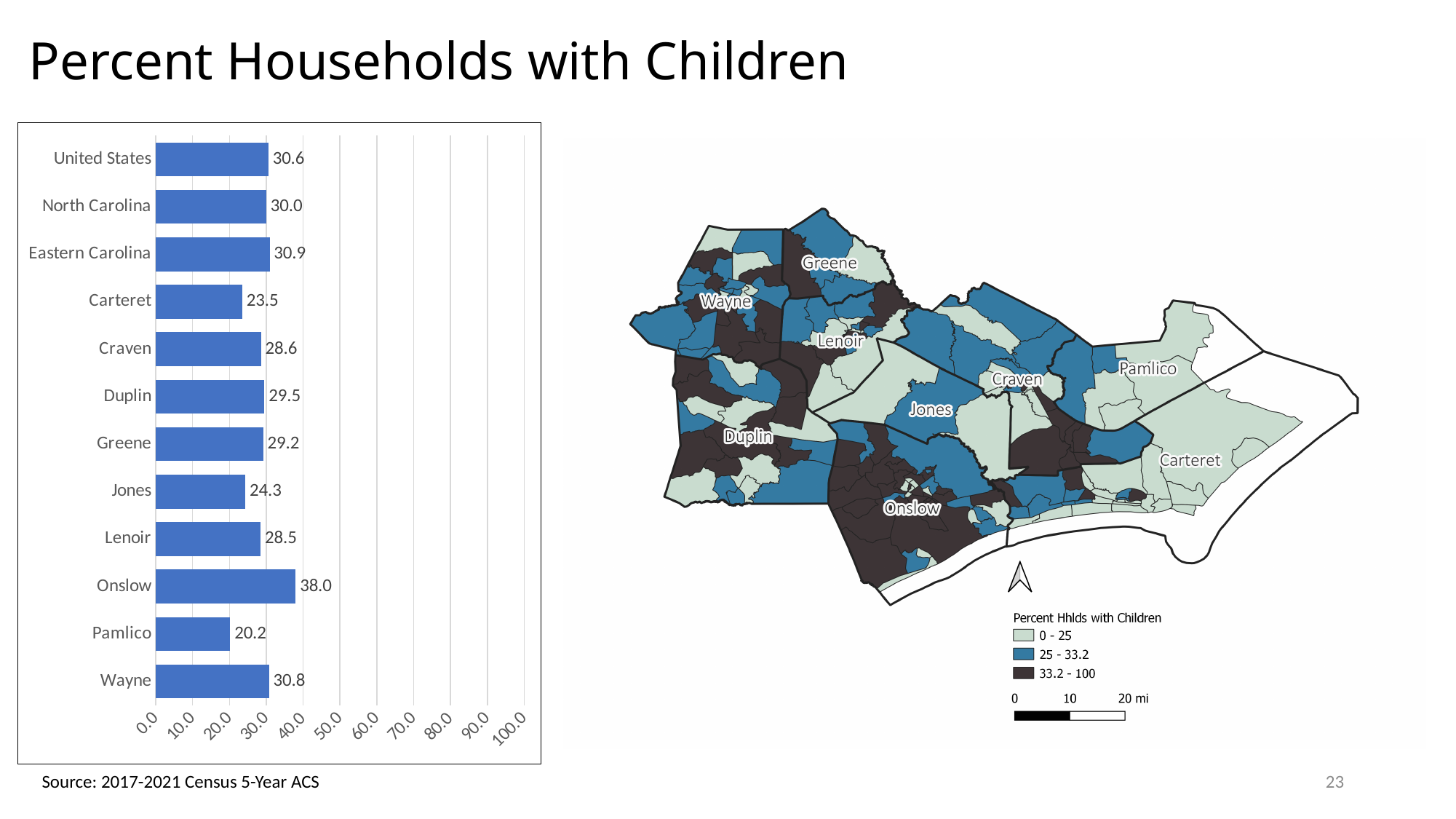
Which category has the highest value in the bar chart? Onslow What is the value for Pamlico in the bar chart? 20.2 What is the highest value shown on the x axis of the bar chart? 100.0 Which is larger in the bar chart, the value for Carteret or the value for Jones? Jones How many categories are shown in the bar chart? 12 What is the value for Onslow in the bar chart? 38.0 What is the difference between the values for Onslow and Pamlico in the bar chart? 17.8 Which category has the lowest value in the bar chart? Pamlico What is the difference between the values for United States and North Carolina in the bar chart? 0.6 Is the value for Onslow in the bar chart greater or less than 30.0? greater What is the value for Eastern Carolina in the bar chart? 30.9 What kind of chart is shown on the left of the slide? Bar chart